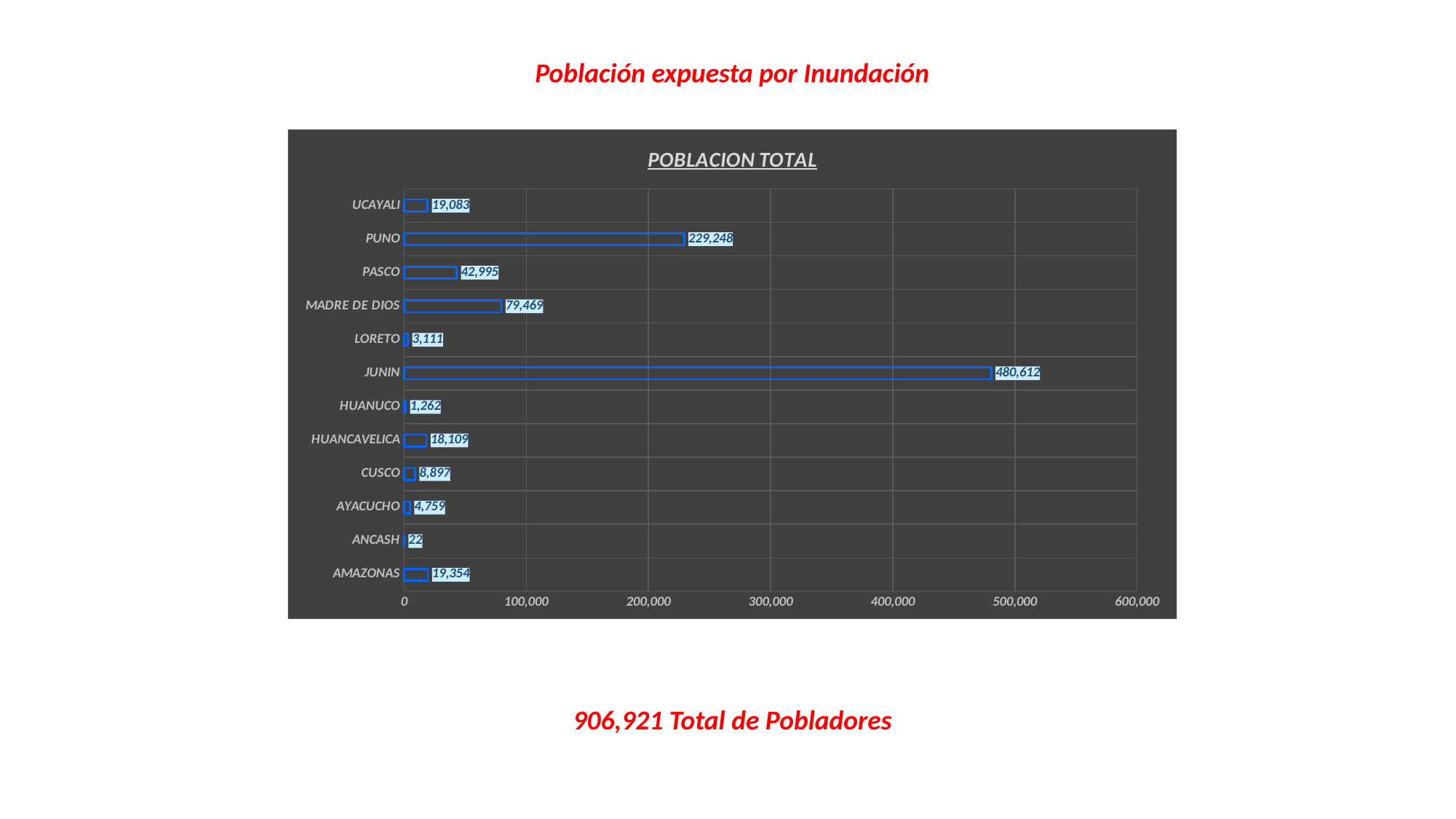
What is the difference between the values for JUNIN and PUNO? 251,364 Which category has the lowest value? ANCASH What is the title of the chart? POBLACION TOTAL What is the value for MADRE DE DIOS? 79,469 What is the value for JUNIN? 480,612 Which category has the highest value? JUNIN What is the value for ANCASH? 22 Is the value for PUNO greater or less than 200,000? greater Which has a larger value, PASCO or MADRE DE DIOS? MADRE DE DIOS What is the difference between the values for PUNO and MADRE DE DIOS? 149,779 What kind of chart is shown on the slide? bar chart How many categories are shown in the chart? 12